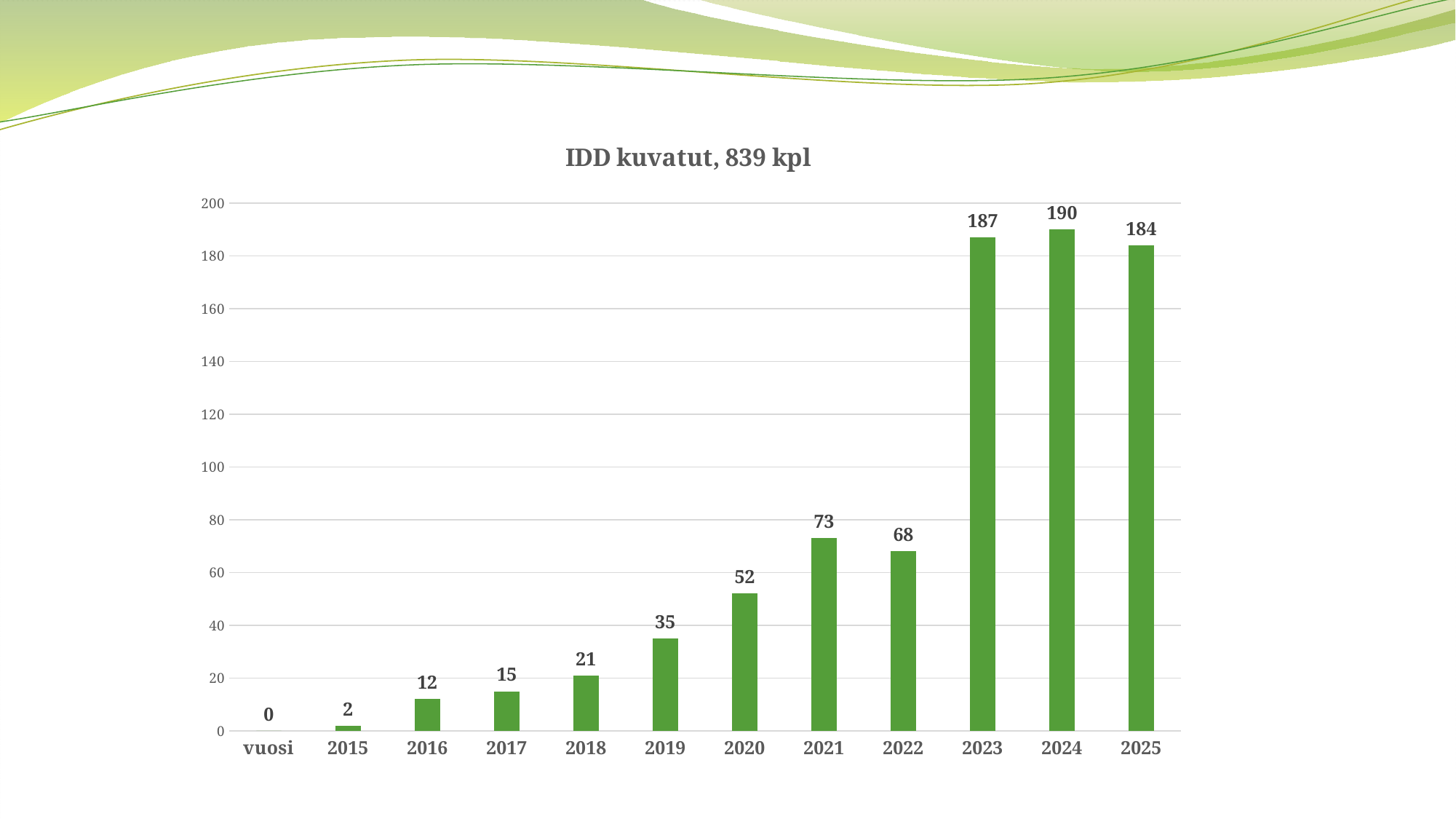
Which year has the highest value? 2024 How many categories are shown on the x axis? 12 Which is larger, the value for 2019 or the value for 2018? 2019 What is the value for 2016? 12 What is the title of the chart? IDD kuvatut, 839 kpl What is the value for 2020? 52 Which category has the lowest value? vuosi Is the value for 2021 greater or less than 60? greater What kind of chart is shown on the slide? bar chart What is the difference between the values for 2024 and 2025? 6 What is the value for 2023? 187 What is the difference between the values for 2021 and 2022? 5